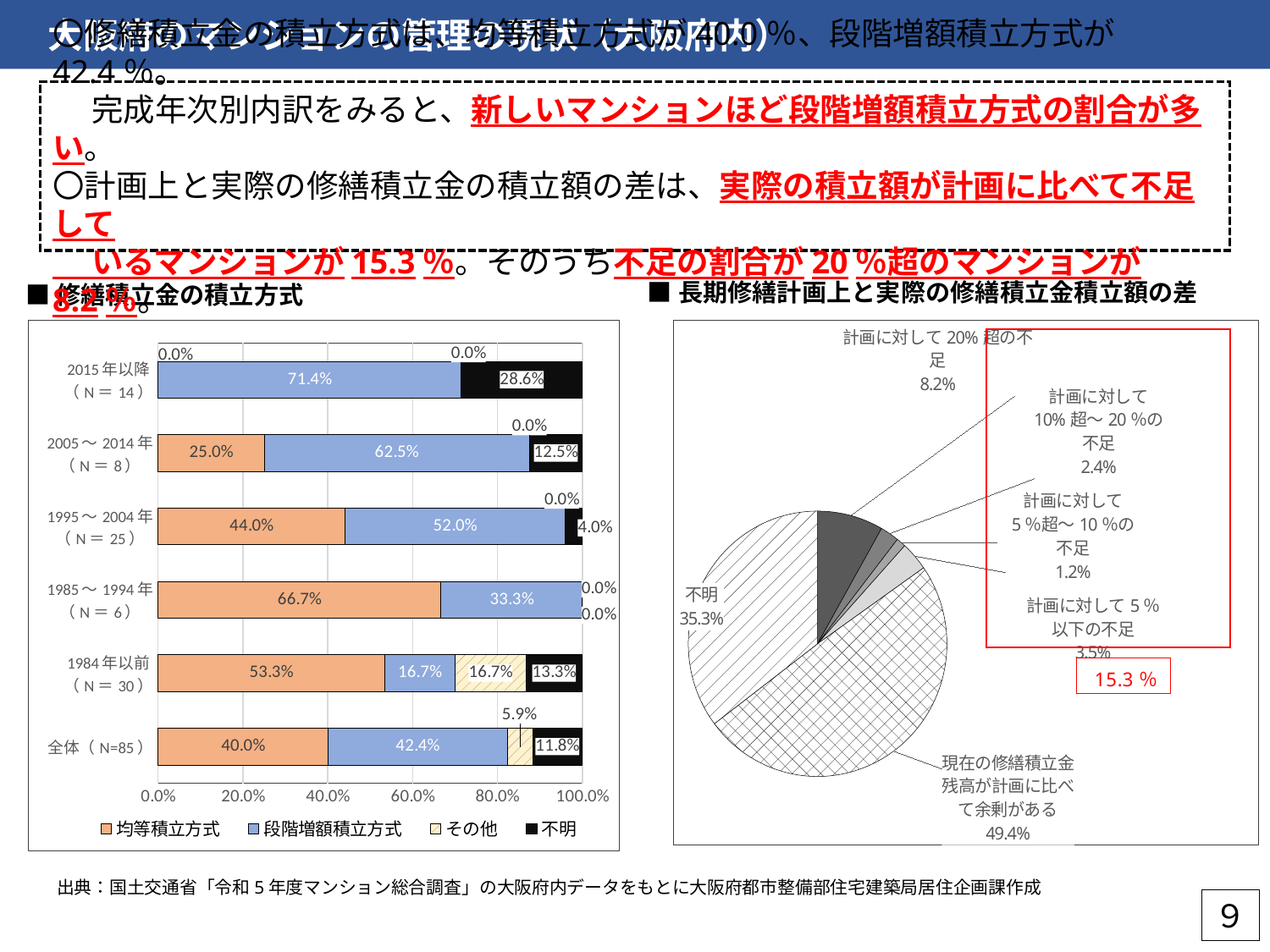
In the bar chart '修繕積立金の積立方式', which completion-year group has the highest share of 均等積立方式? 1985～1994年 (N=6) What type of chart is '長期修繕計画上と実際の修繕積立金積立額の差'? Pie chart How many series does the legend of the bar chart '修繕積立金の積立方式' list? 4 In the bar chart '修繕積立金の積立方式', what is the value of 段階増額積立方式 for 2015年以降 (N=14)? 71.4% In the bar chart '修繕積立金の積立方式', what is the difference between 段階増額積立方式 and 均等積立方式 for 1995～2004年 (N=25)? 8.0% How many completion-year categories (including 全体) are shown in the bar chart '修繕積立金の積立方式'? 6 In the bar chart '修繕積立金の積立方式', which is larger for 2005～2014年 (N=8): 均等積立方式 or 段階増額積立方式? 段階増額積立方式 In the bar chart '修繕積立金の積立方式', what is the value of 均等積立方式 for 全体 (N=85)? 40.0% In the pie chart '長期修繕計画上と実際の修繕積立金積立額の差', what is the share of 計画に対して20%超の不足? 8.2% In the pie chart '長期修繕計画上と実際の修繕積立金積立額の差', which slice is the largest? 現在の修繕積立金残高が計画に比べて余剰がある In the bar chart '修繕積立金の積立方式', what is the value of 不明 for 1984年以前 (N=30)? 13.3% In the pie chart '長期修繕計画上と実際の修繕積立金積立額の差', what is the share of 不明? 35.3%